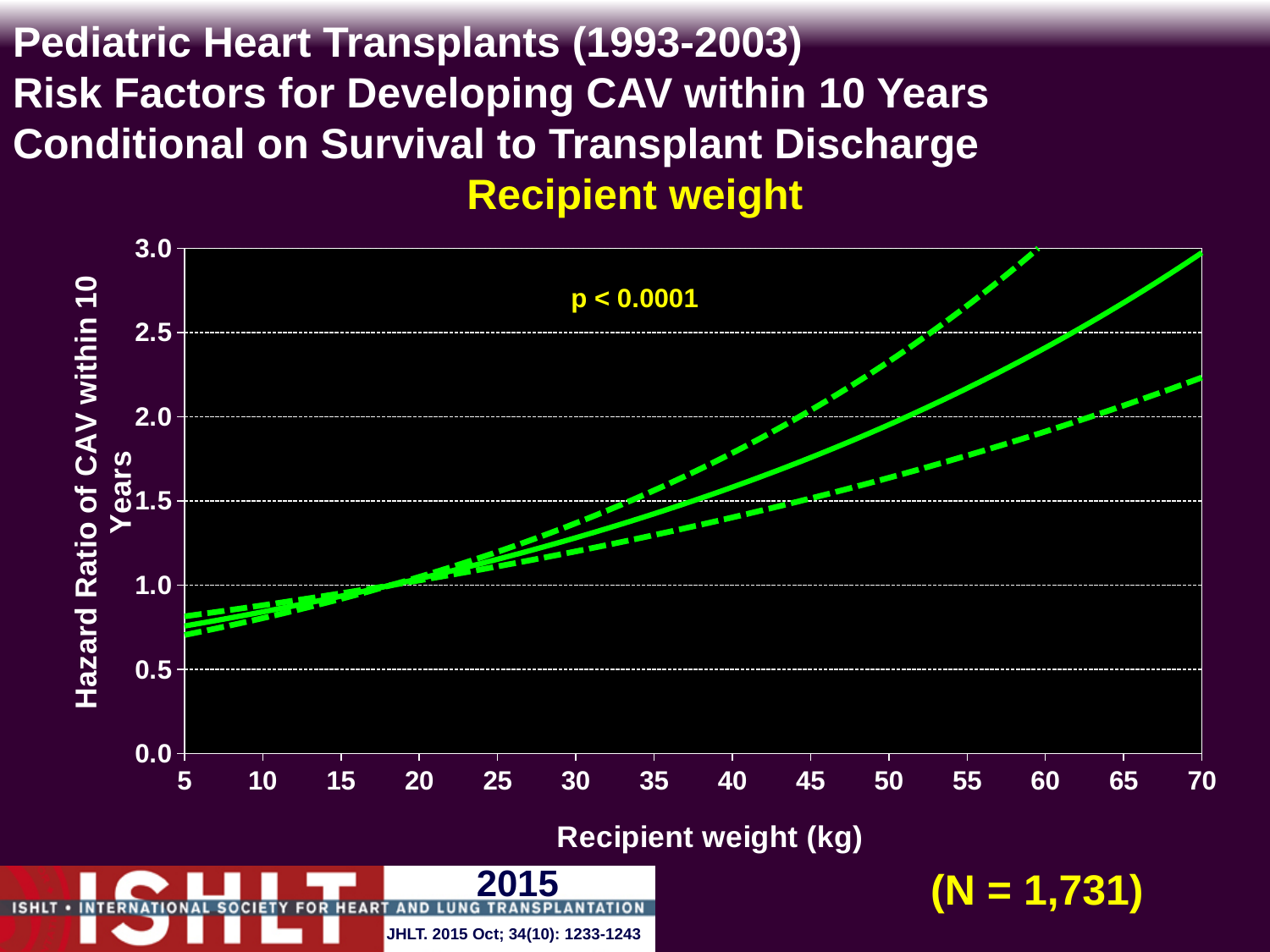
How many lines are plotted on the chart? 3 Is the hazard ratio shown by the solid line at a recipient weight of 30 kg greater or less than 1.5? less Does the hazard ratio of CAV rise or fall as recipient weight increases along the x axis? rise Is the hazard ratio shown by the solid line at a recipient weight of 60 kg greater or less than 2.0? greater Is the hazard ratio shown by the solid line at a recipient weight of 70 kg greater or less than 2.5? greater What is the p-value printed on the chart? p < 0.0001 What is the label of the x axis of the chart? Recipient weight (kg) Is the hazard ratio shown by the solid line higher at a recipient weight of 65 kg or at 25 kg? 65 kg What kind of chart is shown on the slide? line chart